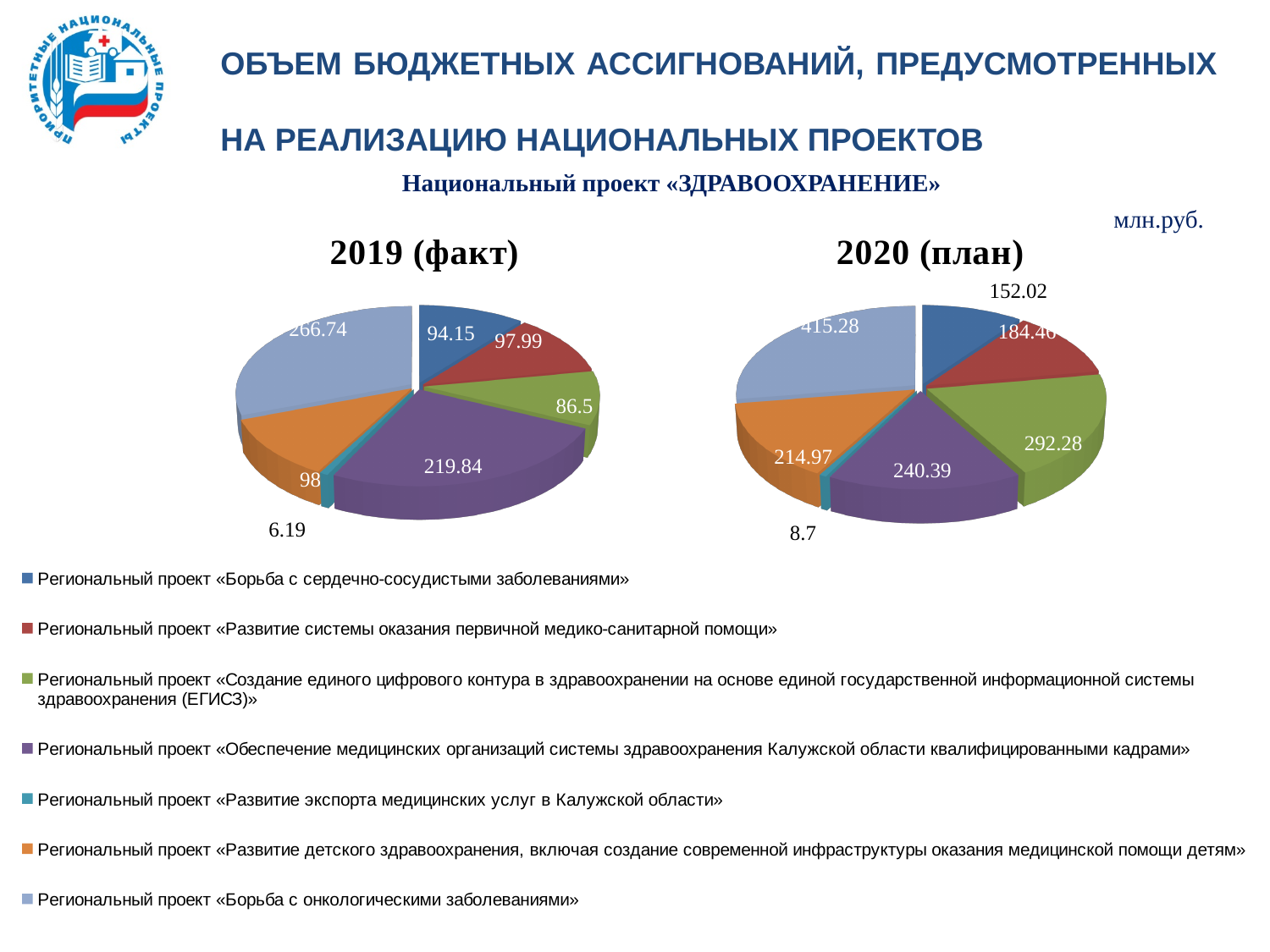
How many regional projects does the legend list? 7 In the 2020 (план) chart, which regional project has the largest value? Региональный проект «Борьба с онкологическими заболеваниями» In the 2020 (план) chart, which is larger: the value for «Развитие детского здравоохранения, включая создание современной инфраструктуры оказания медицинской помощи детям» or the value for «Обеспечение медицинских организаций системы здравоохранения Калужской области квалифицированными кадрами»? Региональный проект «Обеспечение медицинских организаций системы здравоохранения Калужской области квалифицированными кадрами» In the 2020 (план) chart, what is the value for the regional project «Борьба с сердечно-сосудистыми заболеваниями»? 152.02 In the 2019 (факт) chart, what is the value for the regional project «Обеспечение медицинских организаций системы здравоохранения Калужской области квалифицированными кадрами»? 219.84 In the 2020 (план) chart, what is the difference between the values for «Борьба с онкологическими заболеваниями» and «Создание единого цифрового контура в здравоохранении на основе единой государственной информационной системы здравоохранения (ЕГИСЗ)»? 123 What unit of measurement is indicated for the values on the slide? млн.руб. In the 2019 (факт) chart, what is the difference between the values for «Борьба с онкологическими заболеваниями» and «Обеспечение медицинских организаций системы здравоохранения Калужской области квалифицированными кадрами»? 46.9 In the 2019 (факт) chart, which regional project has the smallest value? Региональный проект «Развитие экспорта медицинских услуг в Калужской области» In the 2020 (план) chart, what is the value for the regional project «Развитие экспорта медицинских услуг в Калужской области»? 8.7 What type of chart is used for the 2019 (факт) data? pie chart In the 2019 (факт) chart, what is the value for the regional project «Борьба с онкологическими заболеваниями»? 266.74